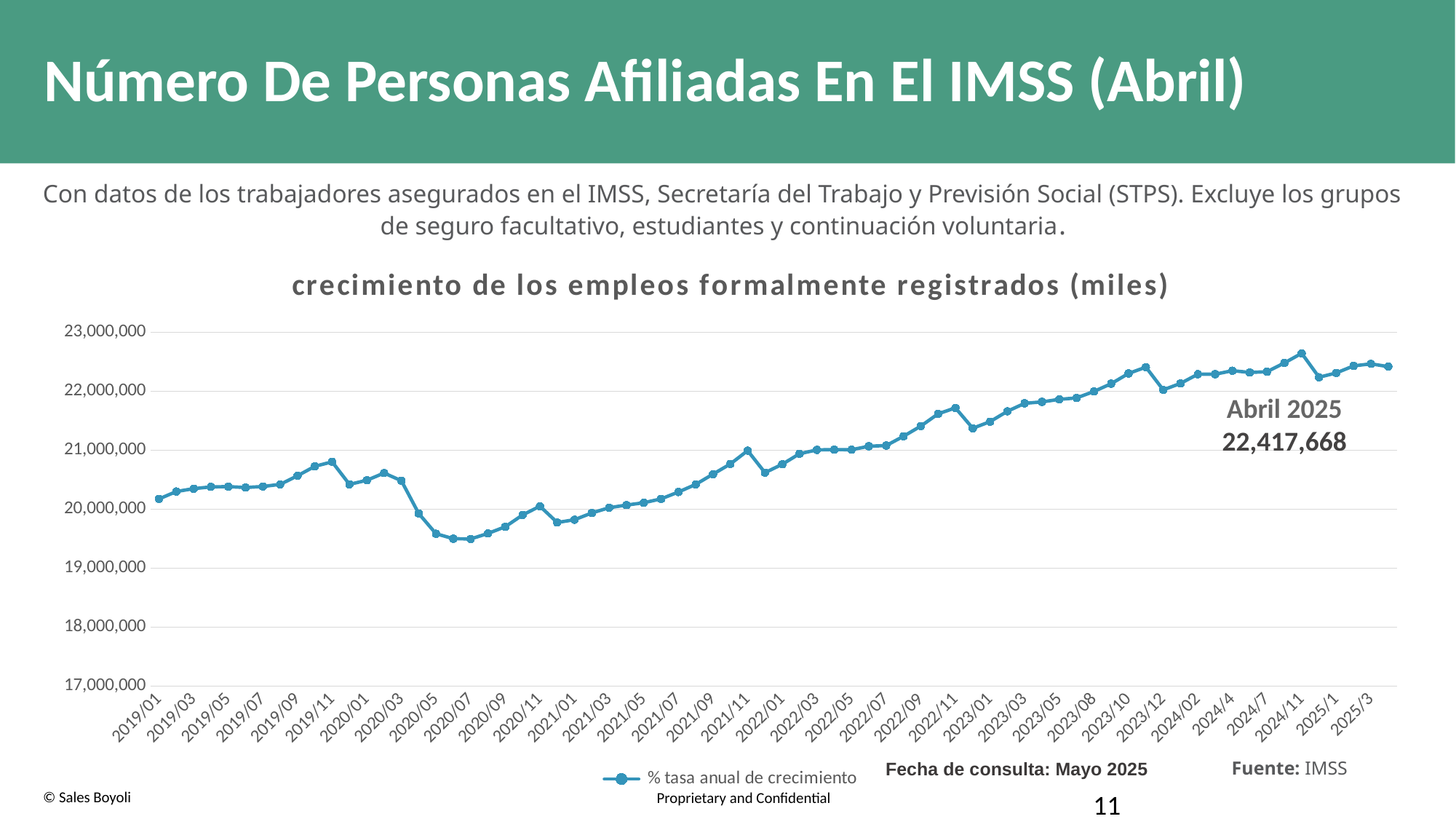
What is the legend entry for the plotted series? % tasa anual de crecimiento What kind of chart is shown on the slide? line chart Which is larger, the value for 2019/01 or the value for 2025/3? 2025/3 How many series does the chart legend list? 1 Is the value for 2023/10 greater or less than 22,000,000? greater Is the value for 2020/07 greater or less than 20,000,000? less Do the values generally rise or fall from 2019/01 to 2025/3? rise What is the title of the chart? crecimiento de los empleos formalmente registrados (miles) Which is larger, the value for 2019/11 or the value for 2020/07? 2019/11 Is the value for 2019/11 greater or less than 21,000,000? less Do the values rise or fall between 2020/03 and 2020/07? fall What value is annotated on the chart for Abril 2025? 22,417,668